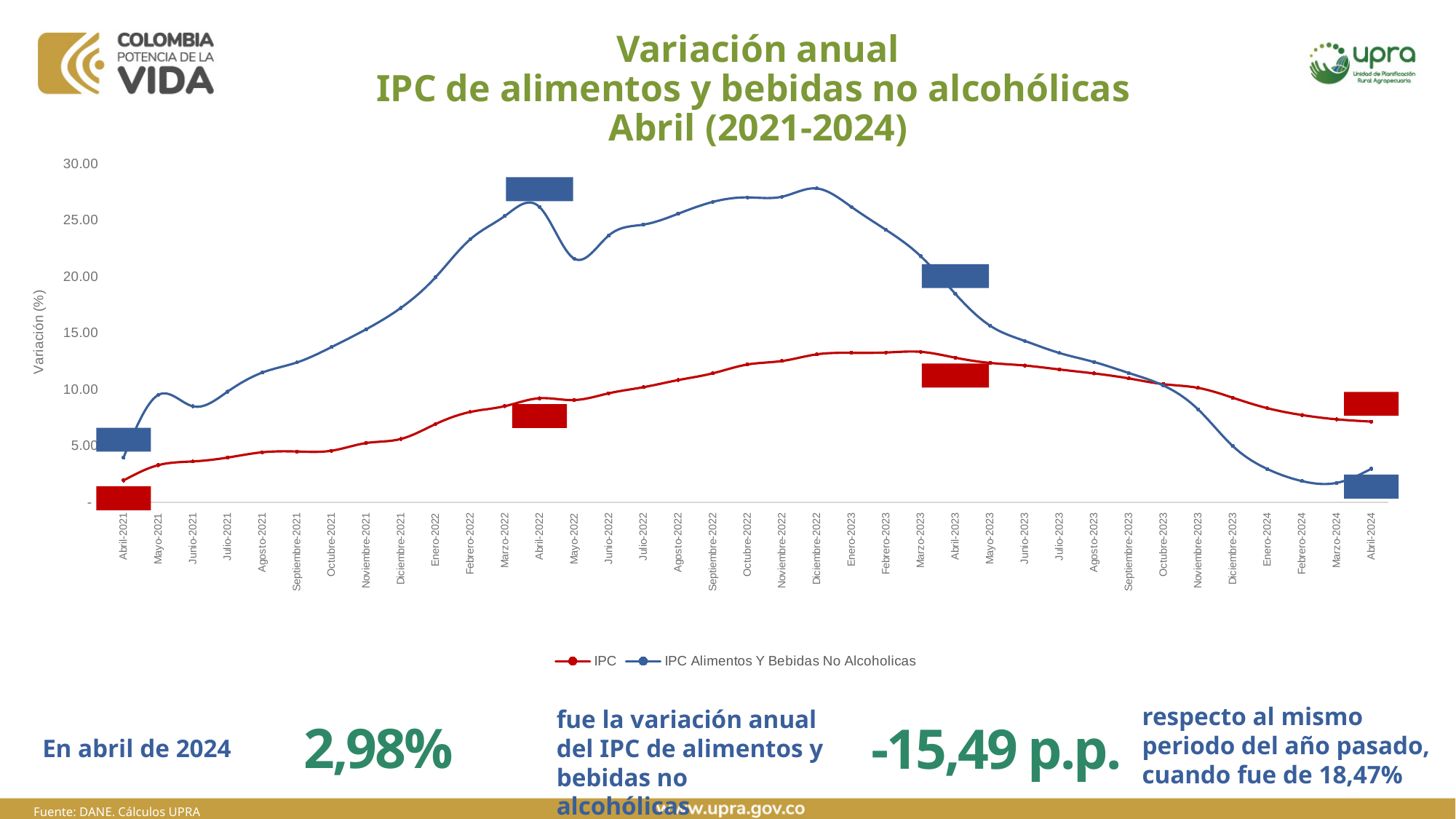
In which month does the IPC Alimentos Y Bebidas No Alcoholicas series reach its highest value? Diciembre-2022 Is the value of IPC Alimentos Y Bebidas No Alcoholicas for Febrero-2024 greater or less than 5.00? less What is the title of the vertical axis? Variación (%) In which month does the IPC series have its lowest value? Abril-2021 Is the value of IPC Alimentos Y Bebidas No Alcoholicas for Diciembre-2022 greater or less than 25.00? greater Does the IPC Alimentos Y Bebidas No Alcoholicas series rise or fall between Diciembre-2022 and Febrero-2024? fall What kind of chart is shown on the slide? line chart What are the two series named in the legend? IPC; IPC Alimentos Y Bebidas No Alcoholicas In Abril-2024, which series has the higher value, IPC or IPC Alimentos Y Bebidas No Alcoholicas? IPC Is the value of IPC for Abril-2021 greater or less than 5.00? less How many series does the legend list? 2 How many months are plotted along the x axis? 37